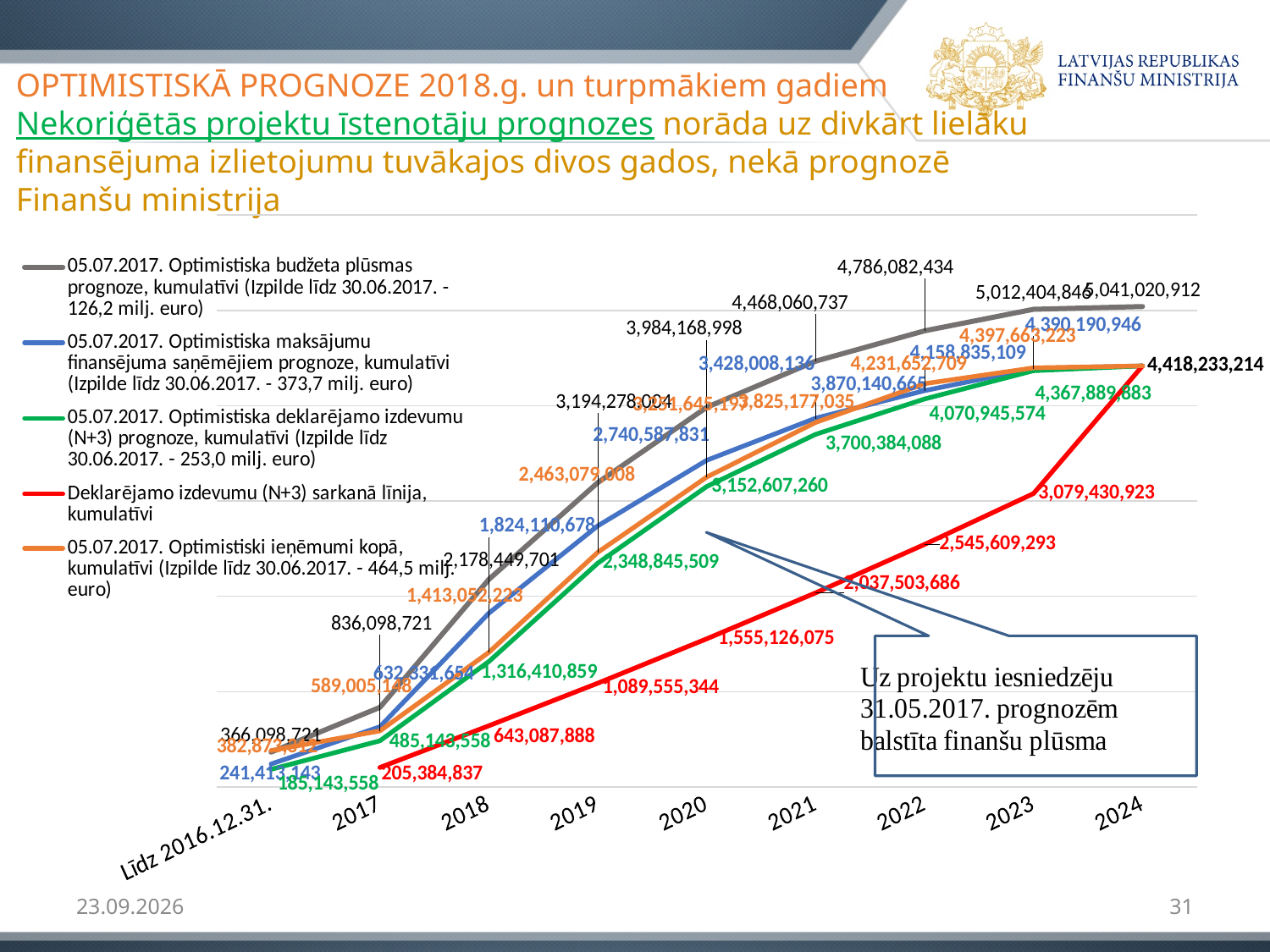
How many series does the legend list? 5 What is the value of the grey series (05.07.2017. Optimistiska budžeta plūsmas prognoze, kumulatīvi) for 2024? 5,041,020,912 What is the difference between the grey series values for 2024 and 2023? 28,616,066 What is the value of the red series (Deklarējamo izdevumu (N+3) sarkanā līnija, kumulatīvi) for 2023? 3,079,430,923 What kind of chart is shown on the slide? line chart What is the value of the blue series (05.07.2017. Optimistiska maksājumu finansējuma saņēmējiem prognoze, kumulatīvi) for 2018? 1,824,110,678 How many categories are shown on the x axis? 9 What is the value of the green series (05.07.2017. Optimistiska deklarējamo izdevumu (N+3) prognoze, kumulatīvi) for 2019? 2,348,845,509 What is the value of the grey series (05.07.2017. Optimistiska budžeta plūsmas prognoze, kumulatīvi) for 2021? 4,468,060,737 Which is larger for 2020: the grey series (budžeta plūsmas prognoze) or the red series (Deklarējamo izdevumu (N+3) sarkanā līnija)? the grey series In which year does the grey series (05.07.2017. Optimistiska budžeta plūsmas prognoze, kumulatīvi) reach its highest value? 2024 What is the value of the red series (Deklarējamo izdevumu (N+3) sarkanā līnija, kumulatīvi) for 2020? 1,555,126,075